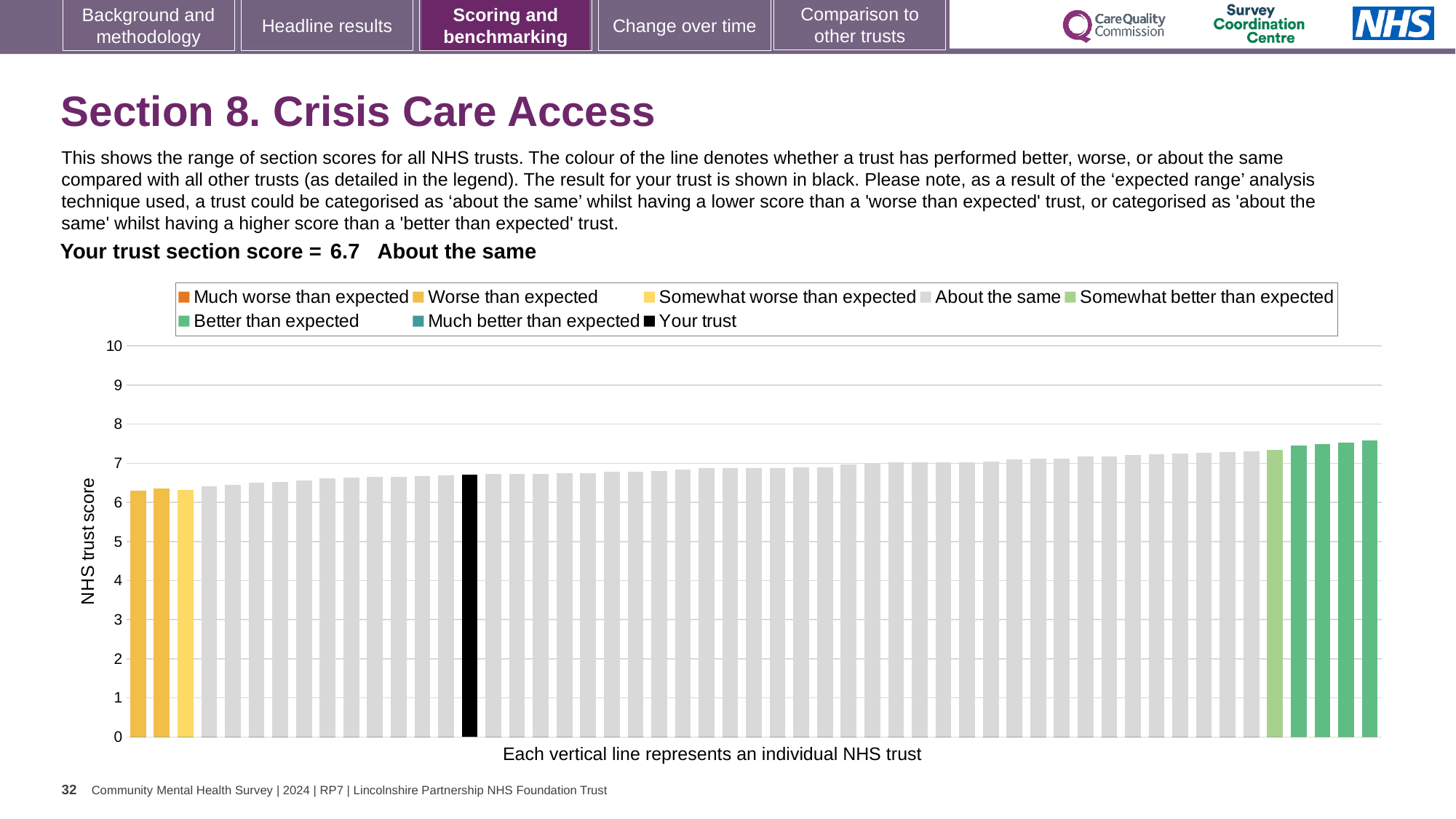
Is the value of the tallest bar greater or less than 8? less Which performance category is your trust's section score placed in? About the same What is the section score for your trust shown on the slide? 6.7 What is the label on the vertical axis of the chart? NHS trust score Is the value of the shortest bar greater or less than 6? greater How many entries does the chart legend list? 8 Is the value of the tallest bar greater or less than 7? greater What colour is the bar representing your trust? black Do the bar values rise or fall from left to right across the chart? rise What kind of chart is shown on the slide? bar chart